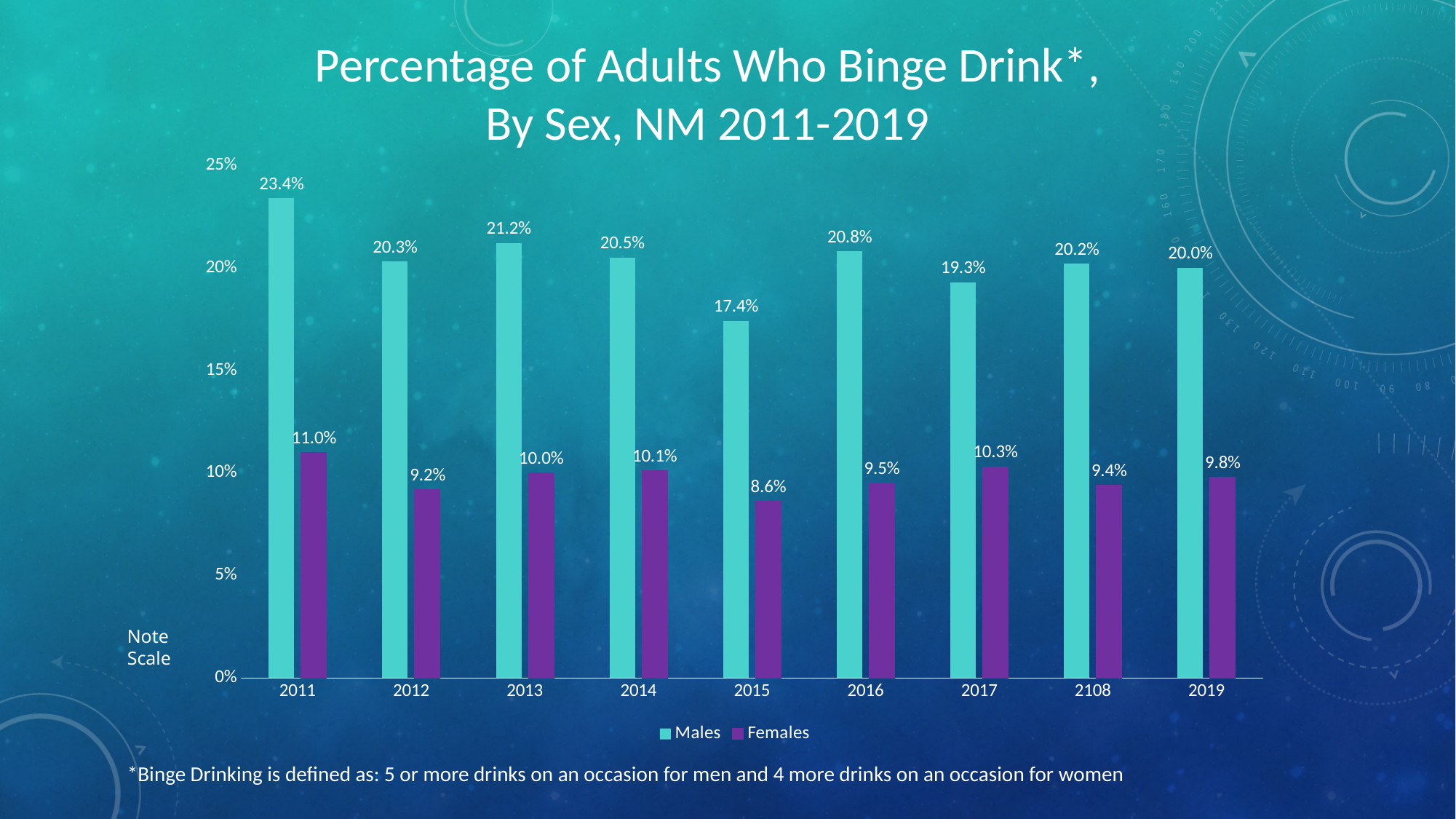
What kind of chart is shown on the slide? bar chart In which year is the Males value highest? 2011 Which is larger, the Males value in 2013 or the Males value in 2016? Males value in 2013 What is the value for Females in 2017? 10.3% Is the Males value for 2015 greater or less than 20%? less How many series does the legend list? 2 What is the value for Females in 2015? 8.6% In which year is the Females value lowest? 2015 How many years are shown on the x axis? 9 What is the value for Males in 2011? 23.4% Which colour represents Females in the chart? purple What is the difference between the Males and Females values in 2019? 10.2%